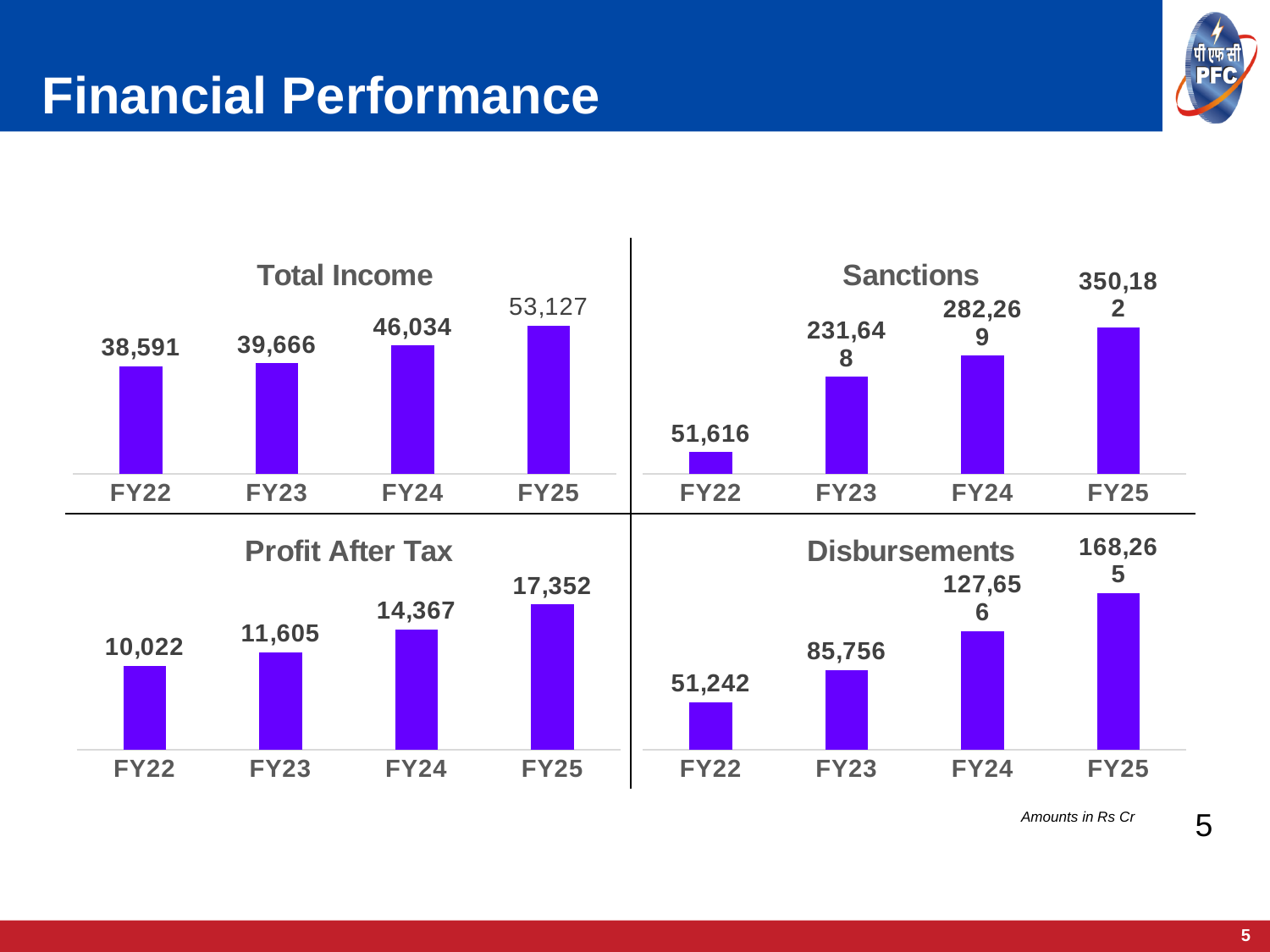
In the Disbursements chart, what is the value for FY23? 85,756 In the Total Income chart, what is the difference between the FY23 and FY22 values? 1,075 In the Profit After Tax chart, what is the difference between the FY25 and FY24 values? 2,985 In the Profit After Tax chart, what is the value for FY22? 10,022 How many fiscal years are shown in the Profit After Tax chart? 4 In the Sanctions chart, do the values rise or fall from FY22 to FY25? Rise What kind of chart is the Disbursements chart? Bar chart In the Total Income chart, what is the value for FY25? 53,127 In the Total Income chart, which fiscal year has the lowest value? FY22 In the Disbursements chart, is the value for FY24 or FY25 larger? FY25 In the Sanctions chart, which fiscal year has the highest value? FY25 In the Sanctions chart, what is the value for FY22? 51,616